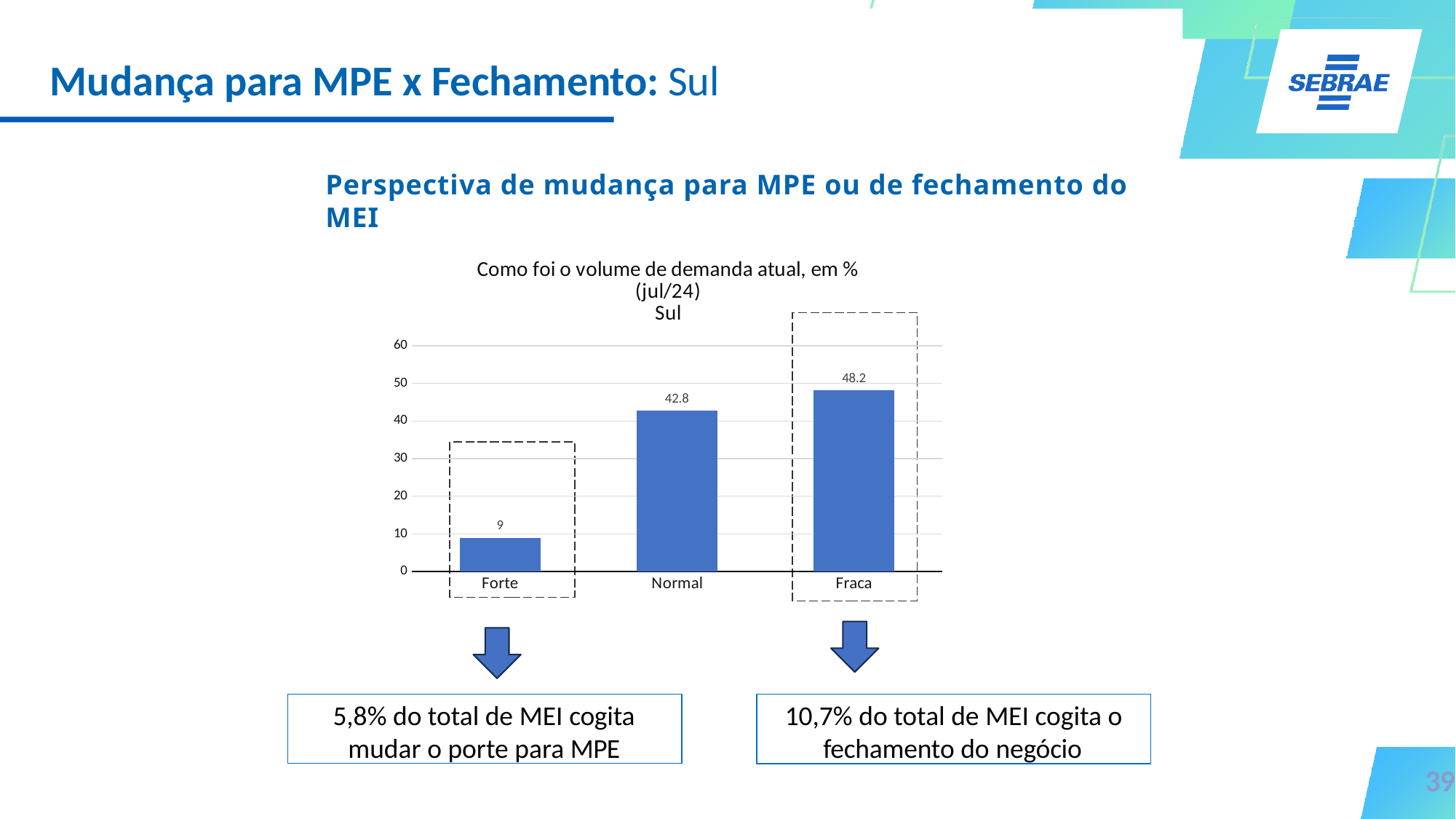
Which category has the lowest value? Forte What is the value for Forte? 9 Which category has the highest value? Fraca How many categories are shown on the x axis? 3 What is the difference between the values for Fraca and Normal? 5.4 What kind of chart is shown on the slide? bar chart Is the value for Fraca greater or less than 40? greater Which is larger, the value for Forte or the value for Normal? Normal What is the difference between the values for Normal and Forte? 33.8 Do the values rise or fall from Forte to Fraca along the x axis? rise What is the value for Normal? 42.8 What is the value for Fraca? 48.2